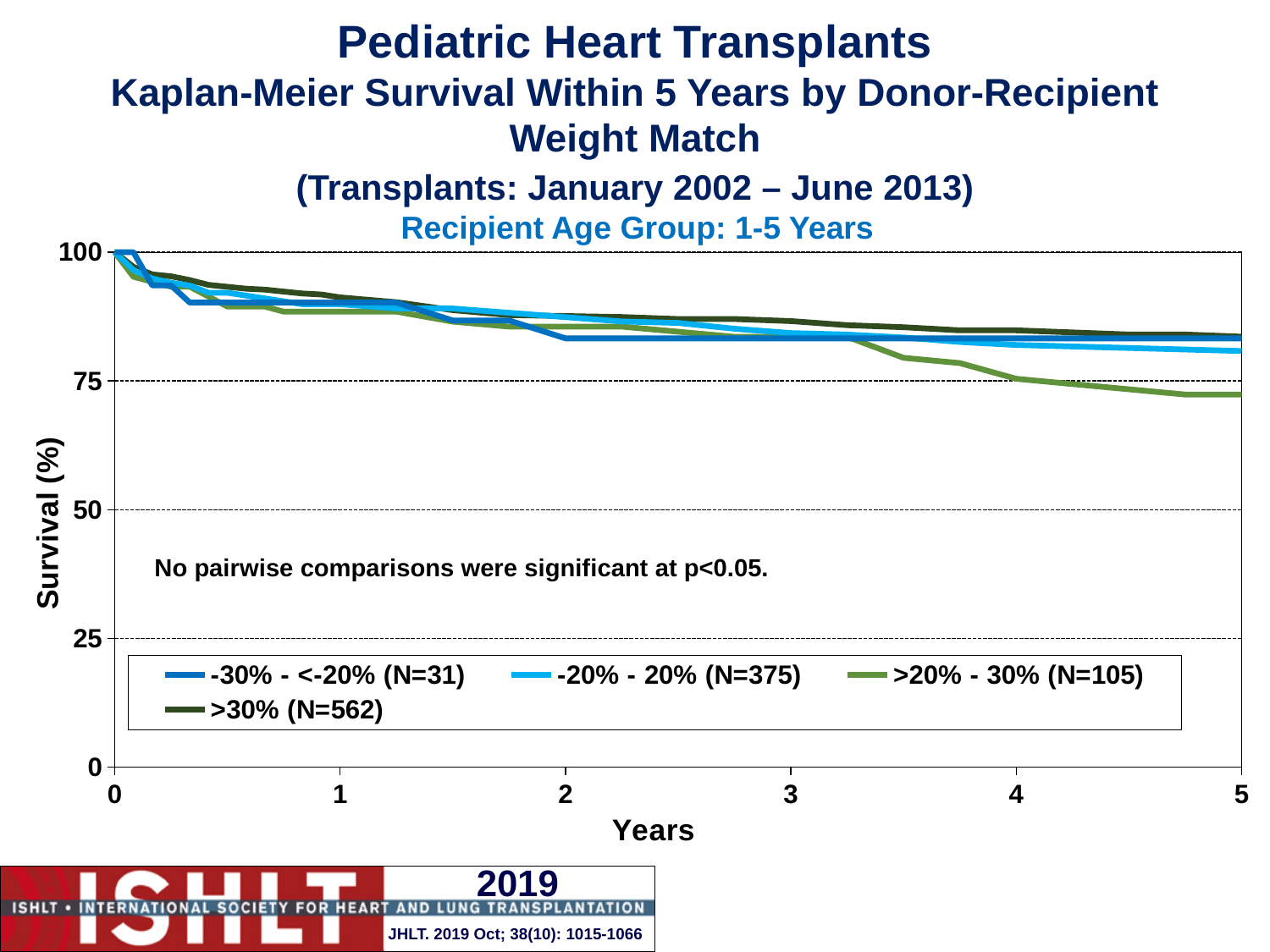
What kind of chart is shown on the slide? Line chart Is the survival for the -30% - <-20% group at 1 year greater or less than 75? greater At 5 years, which group has higher survival: >30% or >20% - 30%? >30% Is the survival for the >30% group at 5 years greater or less than 75? greater Do the survival curves rise or fall as years increase? Fall How many series does the legend list? 4 Is the survival for the >20% - 30% group at 5 years greater or less than 75? less What is the sample size (N) shown in the legend for the >30% group? 562 What is the label of the y axis? Survival (%) Which weight-match group has the lowest survival at 5 years? >20% - 30%